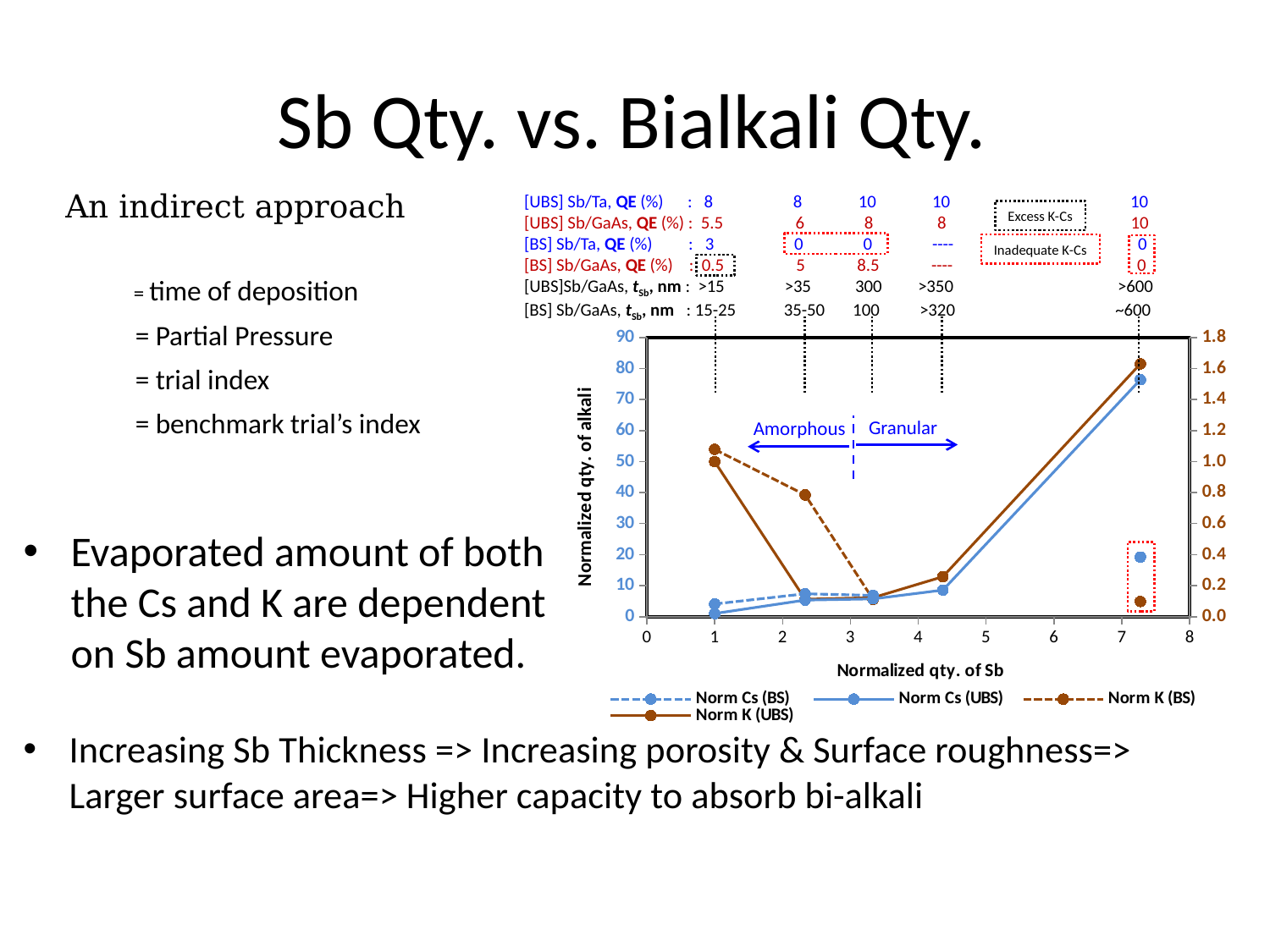
How many data points are plotted for the Norm Cs (UBS) series? 5 Does the Norm Cs (UBS) series rise or fall as the normalized quantity of Sb increases? rise What is the title of the chart's x axis? Normalized qty. of Sb At the rightmost point (near x = 7), which series has the larger value, Norm Cs (BS) or Norm K (BS)? Norm Cs (BS) What is the title of the chart's left y axis? Normalized qty. of alkali Is the value of Norm Cs (UBS) at its leftmost point (near x = 1) greater or less than 10? less How many series does the chart's legend list? 4 Is the value of Norm Cs (BS) at its rightmost point (near x = 7) greater or less than 30? less What kind of chart is shown on the slide? line chart